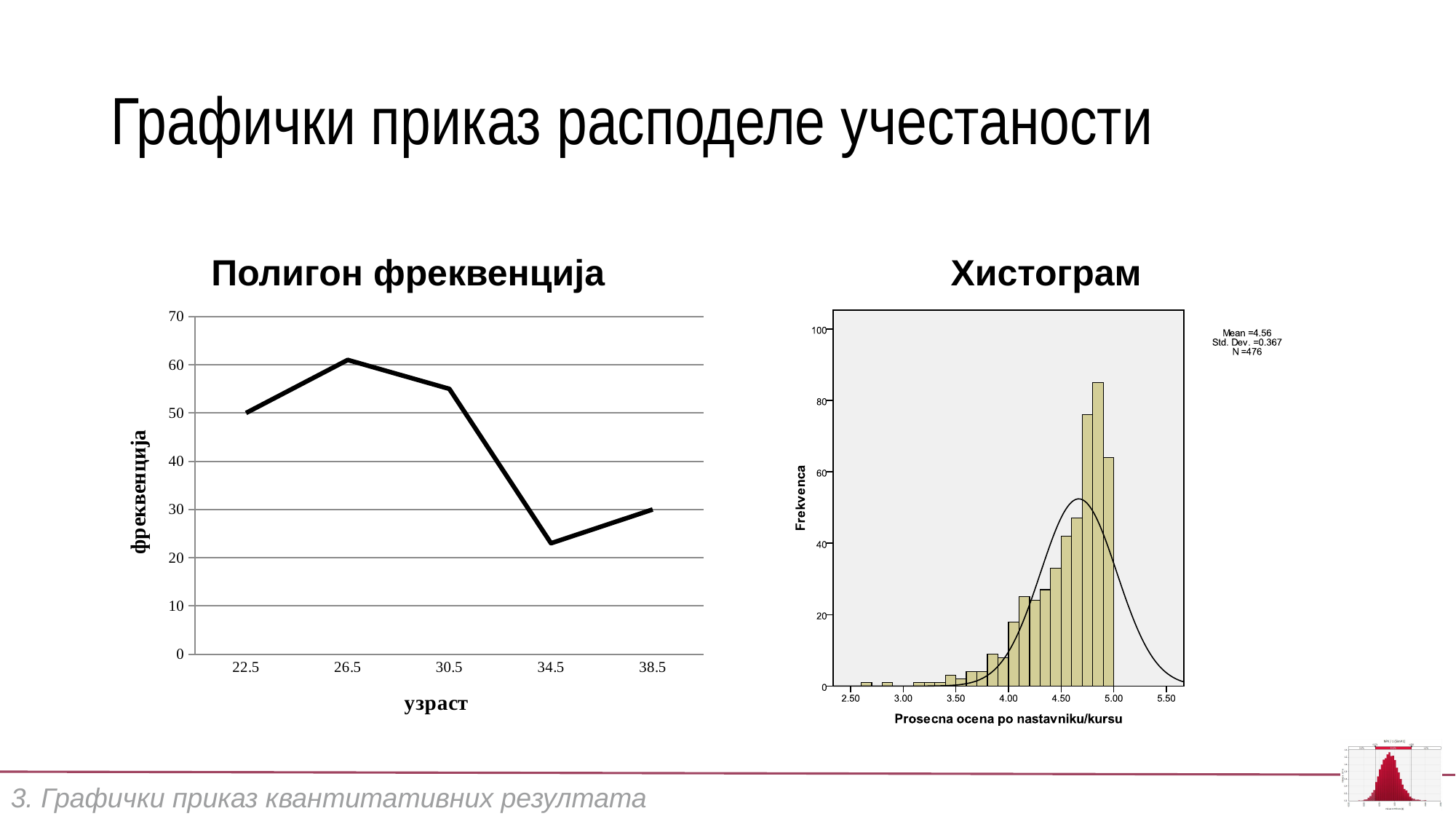
In the 'Полигон фреквенција' chart, what is the difference between the frequencies for ages 22.5 and 38.5? 20 In the 'Полигон фреквенција' chart, is the frequency for age 34.5 greater or less than 30? less How many age categories are plotted on the x axis of the 'Полигон фреквенција' chart? 5 What is the x-axis label of the 'Полигон фреквенција' chart? узраст In the 'Полигон фреквенција' chart, which age has the lowest frequency? 34.5 In the 'Полигон фреквенција' chart, what is the frequency for age 38.5? 30 What kind of chart is the 'Полигон фреквенција' chart on the left? line chart In the 'Полигон фреквенција' chart, which has a higher frequency, age 30.5 or age 38.5? 30.5 In the 'Хистограм' chart on the right, what is the value of N shown in the annotation? 476 In the 'Полигон фреквенција' chart, which age has the highest frequency? 26.5 In the 'Полигон фреквенција' chart, what is the frequency for age 22.5? 50